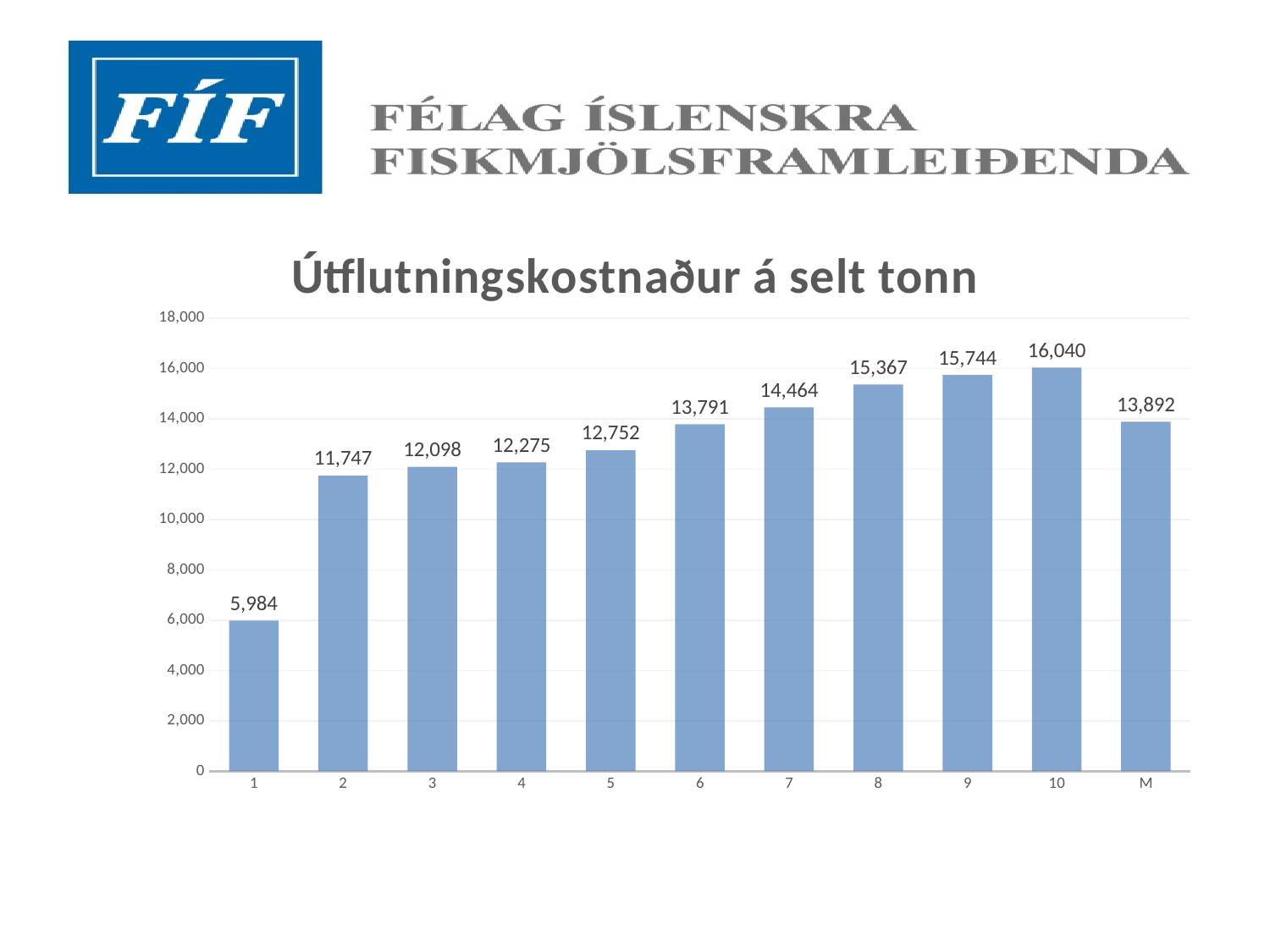
What is the value for category 1? 5,984 What is the title of the chart? Útflutningskostnaður á selt tonn Which is larger, the value for category 6 or the value for category M? M Which category has the highest value? 10 Is the value for category 5 greater or less than 14,000? less What is the difference between the values for category 10 and category 1? 10,056 What kind of chart is shown on the slide? bar chart What is the difference between the values for category 9 and category 8? 377 Which category has the lowest value? 1 How many bars are shown in the chart? 11 What is the value for category 7? 14,464 What is the value for category M? 13,892